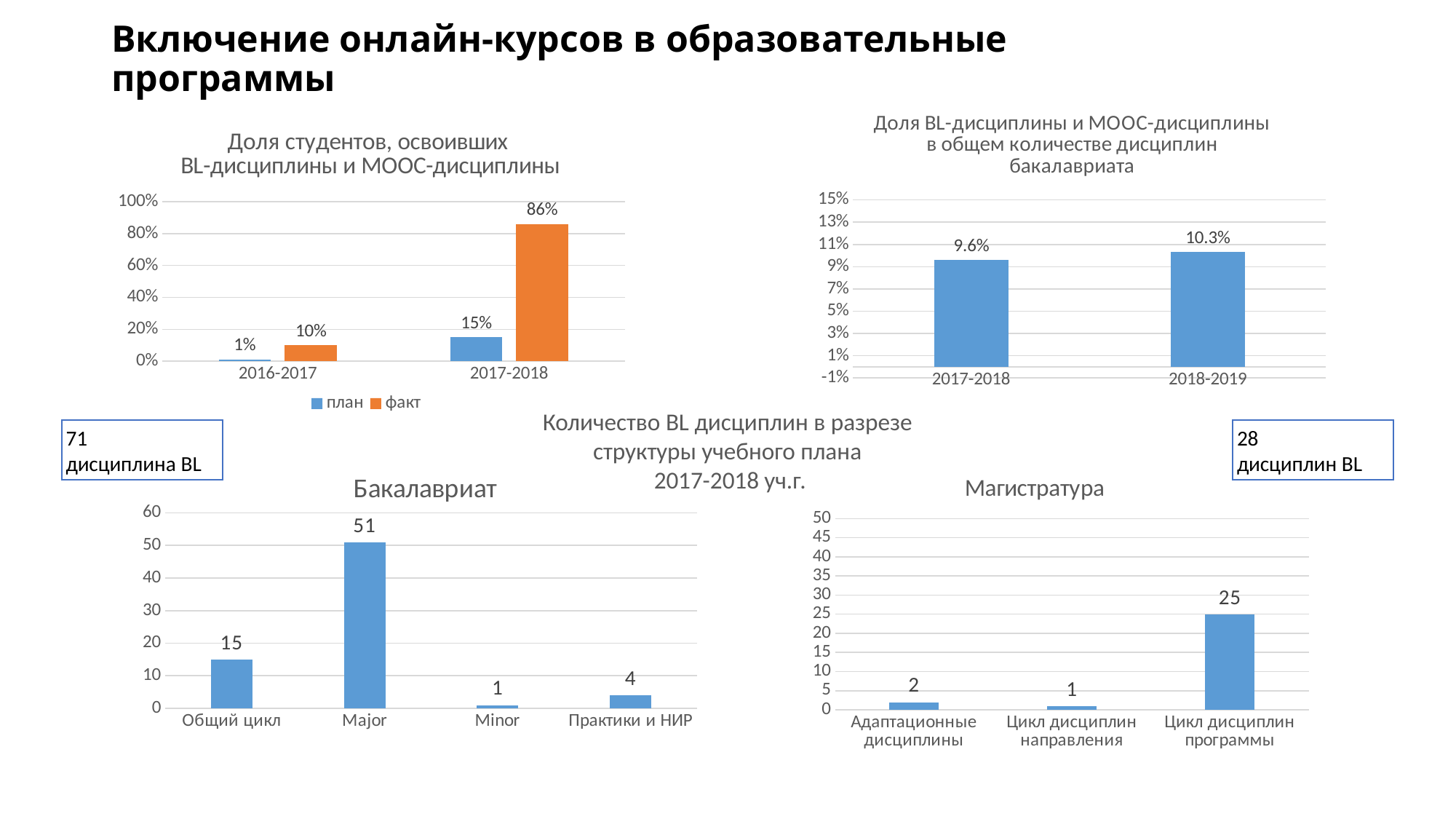
In the chart 'Доля студентов, освоивших BL-дисциплины и MOOC-дисциплины', what is the difference between 'факт' and 'план' for 2017-2018? 71% In the 'Бакалавриат' chart, which category has the highest value? Major In the 'Бакалавриат' chart, which category has the lowest value? Minor In the chart 'Доля BL-дисциплины и MOOC-дисциплины в общем количестве дисциплин бакалавриата', what is the value for 2018-2019? 10.3% In the chart 'Доля студентов, освоивших BL-дисциплины и MOOC-дисциплины', what is the 'план' value for 2016-2017? 1% In the chart 'Доля BL-дисциплины и MOOC-дисциплины в общем количестве дисциплин бакалавриата', do the values rise or fall from 2017-2018 to 2018-2019? rise In the 'Магистратура' chart, what is the value for 'Цикл дисциплин программы'? 25 How many series does the legend of the chart 'Доля студентов, освоивших BL-дисциплины и MOOC-дисциплины' list? 2 What type of chart is the 'Магистратура' chart? bar chart In the 'Бакалавриат' chart, what is the value for 'Общий цикл'? 15 How many categories are shown in the 'Магистратура' chart? 3 In the chart 'Доля студентов, освоивших BL-дисциплины и MOOC-дисциплины', what is the 'факт' value for 2017-2018? 86%